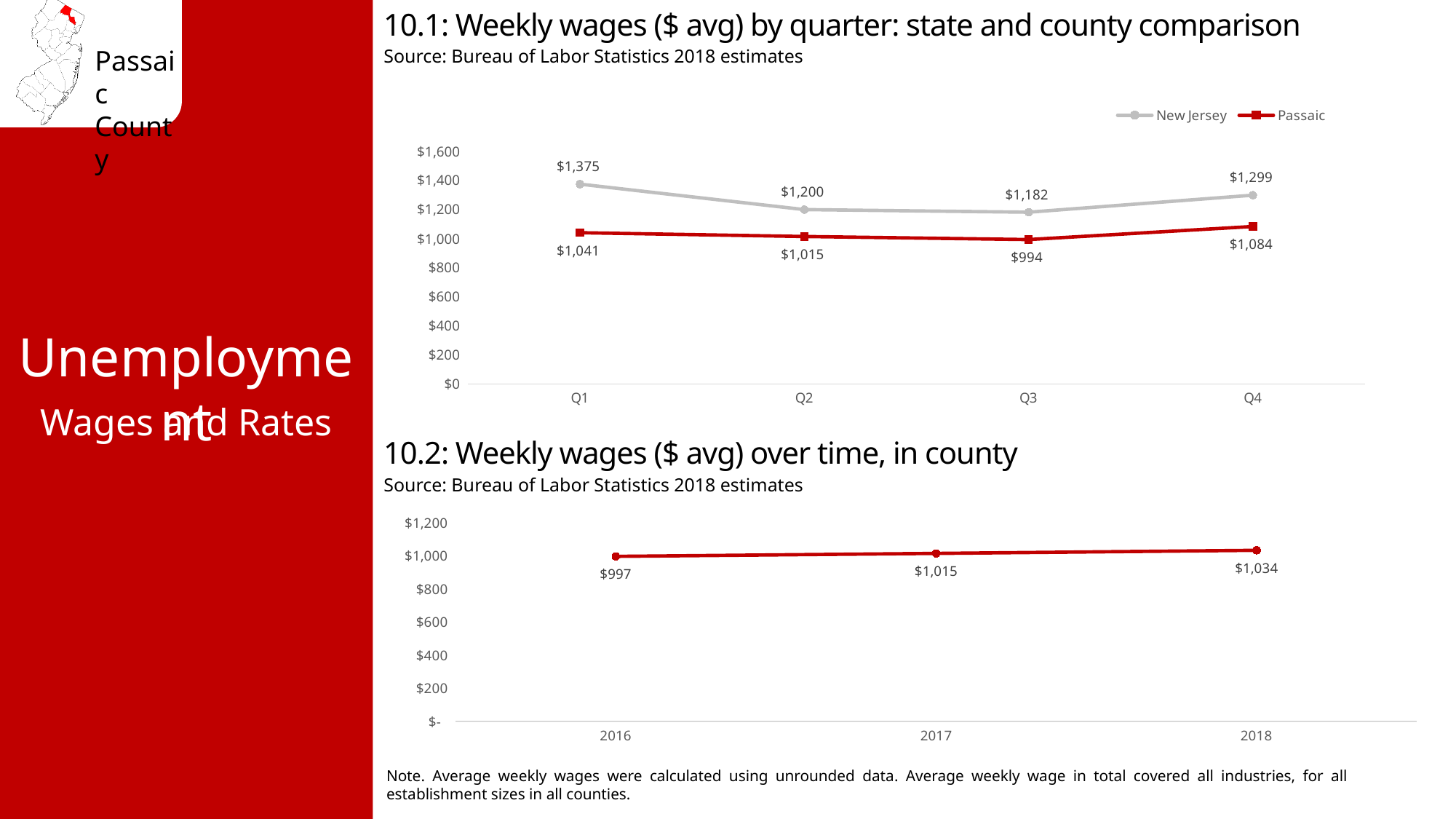
In chart 10.1, which is larger in Q2: the New Jersey wage or the Passaic wage? New Jersey In chart 10.1, which quarter has the lowest Passaic weekly wage? Q3 In chart 10.1, what is the Passaic weekly wage in Q3? $994 How many series does the legend in chart 10.1 list? 2 In chart 10.1, which quarter has the highest New Jersey weekly wage? Q1 In chart 10.1, what is the difference between the New Jersey and Passaic weekly wages in Q4? $215 In chart 10.2, what is the difference between the 2018 and 2016 weekly wages? $37 In chart 10.1, what is the New Jersey weekly wage in Q1? $1,375 What type of chart is chart 10.2? Line chart In chart 10.2, do the weekly wages rise or fall from 2016 to 2018? Rise How many years are plotted in chart 10.2? 3 In chart 10.2, what is the weekly wage for 2018? $1,034